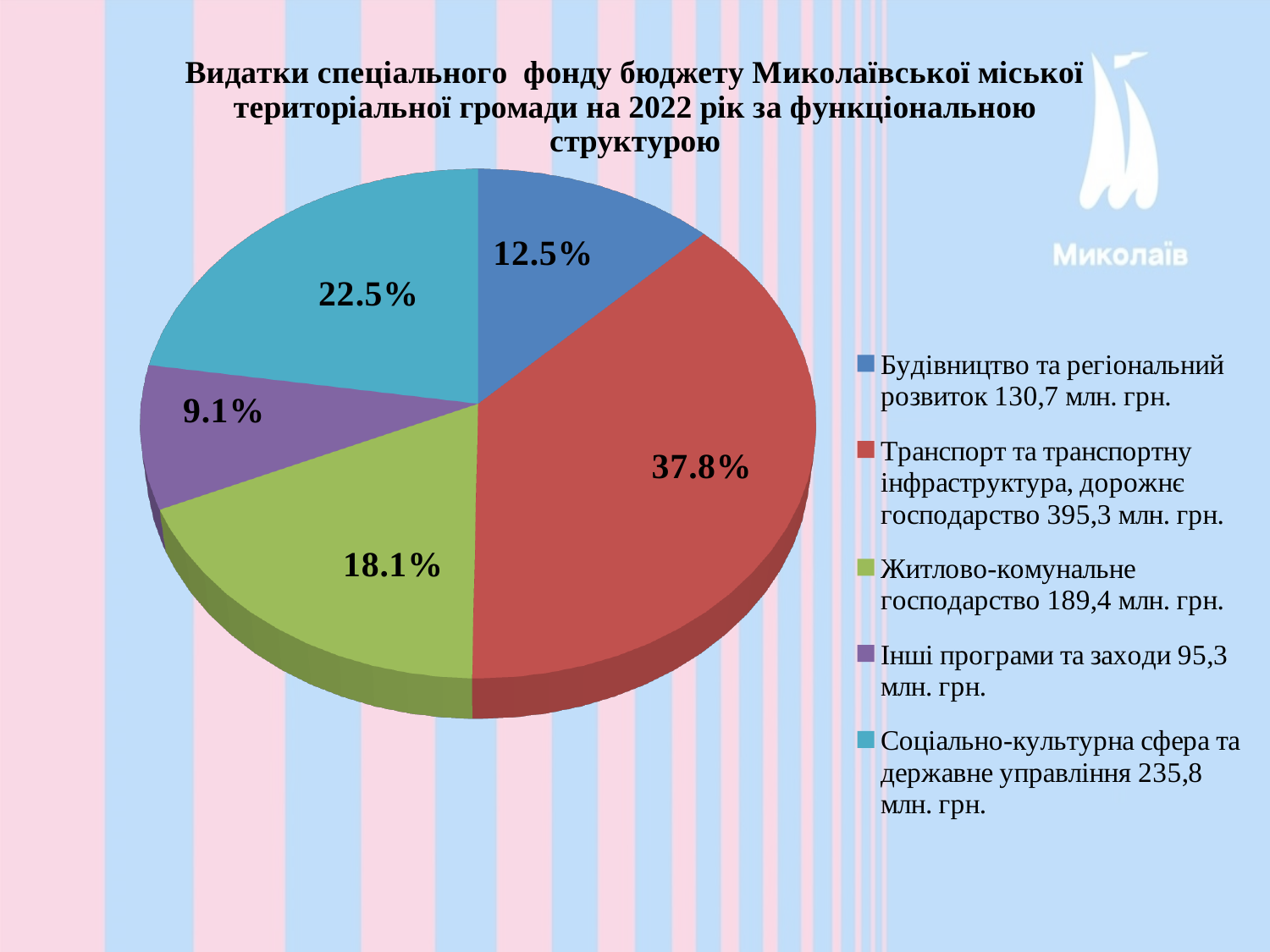
What is the difference in percentage points between the Транспорт slice (37.8%) and the Соціально-культурна сфера та державне управління slice (22.5%)? 15.3 What share of the pie is labelled for Транспорт та транспортну інфраструктура, дорожнє господарство? 37.8% What share of the pie is labelled for Будівництво та регіональний розвиток? 12.5% What share of the pie is labelled for Інші програми та заходи? 9.1% What kind of chart is shown on the slide? Pie chart Which category has the smallest slice of the pie? Інші програми та заходи According to the legend, what amount in млн. грн. is given for Будівництво та регіональний розвиток? 130,7 млн. грн. Which slice is larger: Житлово-комунальне господарство or Соціально-культурна сфера та державне управління? Соціально-культурна сфера та державне управління How many slices does the pie chart have? 5 Which category has the largest slice of the pie? Транспорт та транспортну інфраструктура, дорожнє господарство According to the legend, what amount in млн. грн. is given for Житлово-комунальне господарство? 189,4 млн. грн. What colour is the slice for Транспорт та транспортну інфраструктура, дорожнє господарство? Red